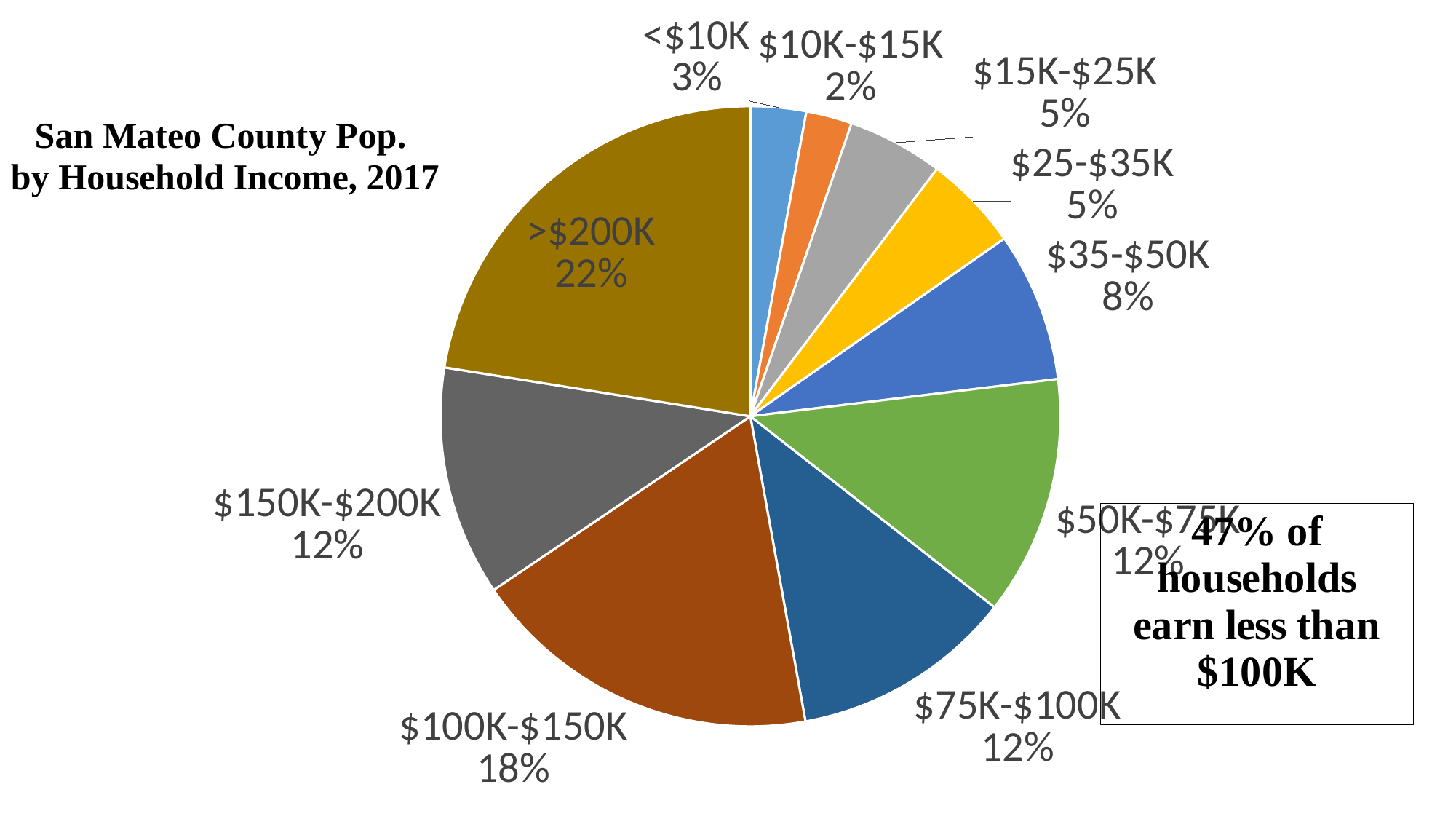
According to the text box on the slide, what percentage of households earn less than $100K? 47% Which income bracket has the smallest share of households? $10K-$15K Which income bracket has the largest share of households? >$200K What share of households fall in the $100K-$150K income bracket? 18% How many percentage points larger is the >$200K slice than the $100K-$150K slice? 4 How many income brackets are shown in the pie chart? 10 What share of households earn less than $10K? 3% What share of households are in the $35K-$50K bracket? 8% What type of chart is shown on the slide? Pie chart What is the title of the chart? San Mateo County Pop. by Household Income, 2017 What share of San Mateo County households earn more than $200K? 22% Which slice is larger: $35K-$50K or $15K-$25K? $35K-$50K